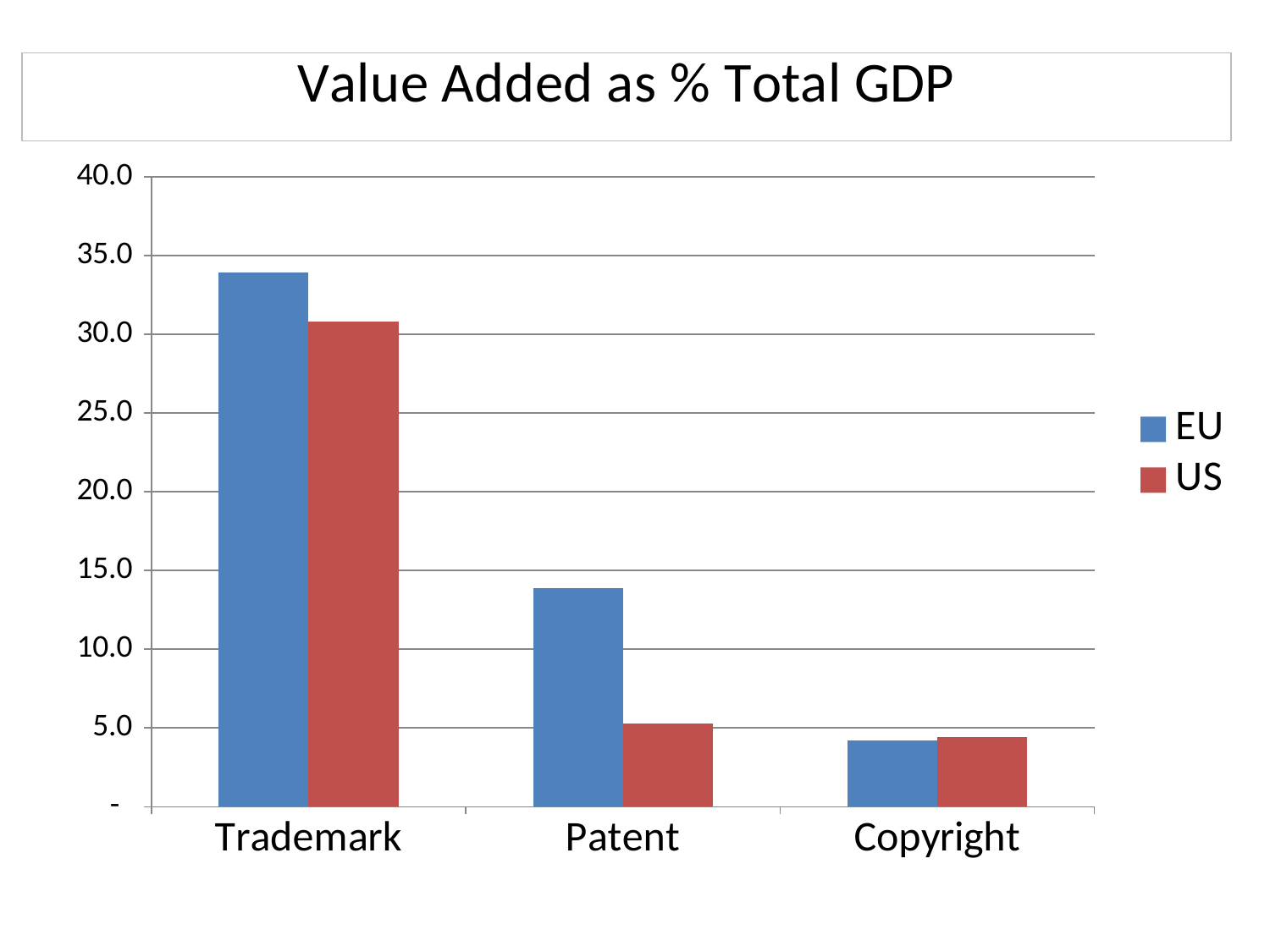
Which category has the lowest US value? Copyright What is the title of the chart? Value Added as % Total GDP For Patent, which is larger, the EU value or the US value? EU How many categories are shown on the x axis? 3 Is the EU value for Patent greater or less than 10.0? greater How many series does the legend list? 2 For Trademark, which is larger, the EU value or the US value? EU What type of chart is shown on the slide? bar chart Which category has the highest EU value? Trademark Is the US value for Patent greater or less than 10.0? less Which category has the lowest EU value? Copyright Is the EU value for Trademark greater or less than 30.0? greater